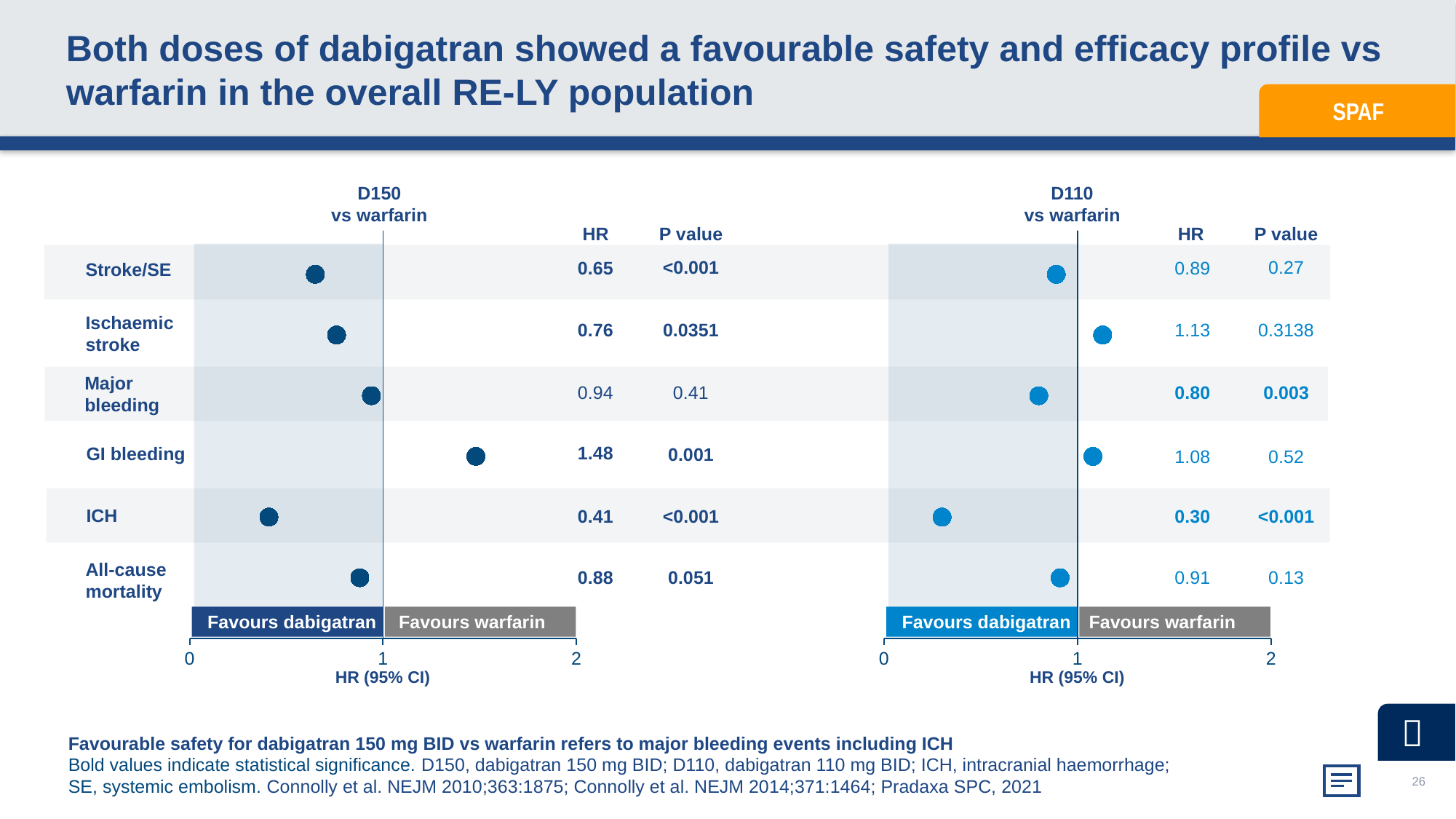
What is the x-axis label of the D110 vs warfarin chart? HR (95% CI) In the D110 vs warfarin chart, is the HR for Ischaemic stroke greater or less than 1? greater In the D150 vs warfarin chart, what is the HR for GI bleeding? 1.48 In the D110 vs warfarin chart, what is the HR for Major bleeding? 0.80 In the D150 vs warfarin chart, which outcome has the highest HR? GI bleeding In the D110 vs warfarin chart, which outcome has the lowest HR? ICH How many outcomes are plotted in the D150 vs warfarin chart? 6 In the D110 vs warfarin chart, what is the HR for ICH? 0.30 In the D150 vs warfarin chart, what is the P value for Ischaemic stroke? 0.0351 What kind of chart is used to show the hazard ratios on this slide? Forest plot (dot plot) Which is larger: the HR for Ischaemic stroke in the D150 vs warfarin chart or in the D110 vs warfarin chart? D110 vs warfarin In the D150 vs warfarin chart, what is the difference between the HR for GI bleeding and the HR for ICH? 1.07